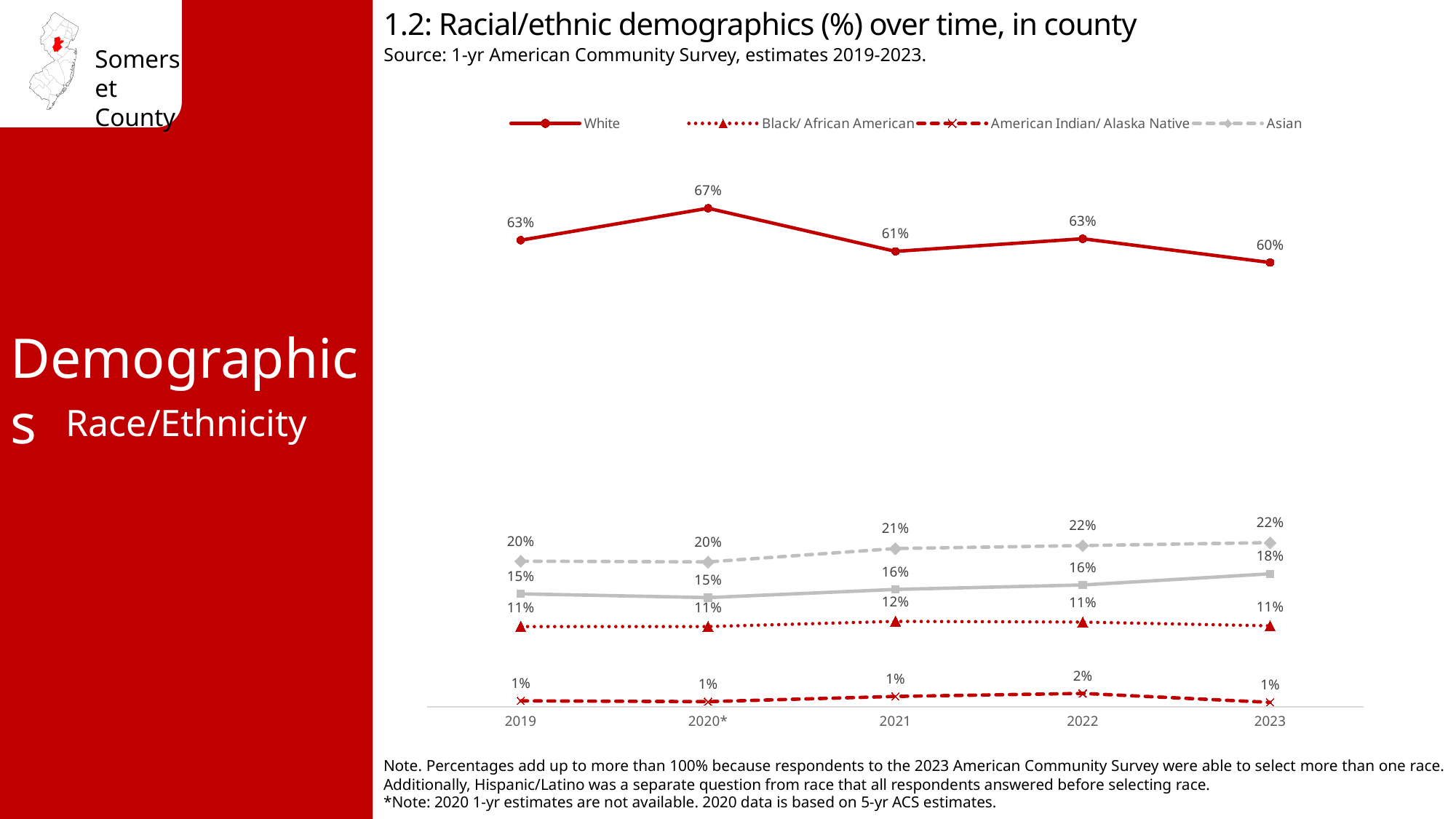
What is the difference between the White percentage in 2020* and in 2023? 7% How many series does the legend list? 4 Did the Asian percentage rise or fall from 2019 to 2023? Rise In which year was the White percentage highest? 2020* What kind of chart is shown on the slide? Line chart What was the White percentage in 2020*? 67% In which year was the White percentage lowest? 2023 What was the Black/ African American percentage in 2021? 12% How many years are shown on the x axis? 5 What was the Asian percentage in 2023? 22% Which was larger in 2019, the White percentage or the Asian percentage? White What was the American Indian/ Alaska Native percentage in 2022? 2%